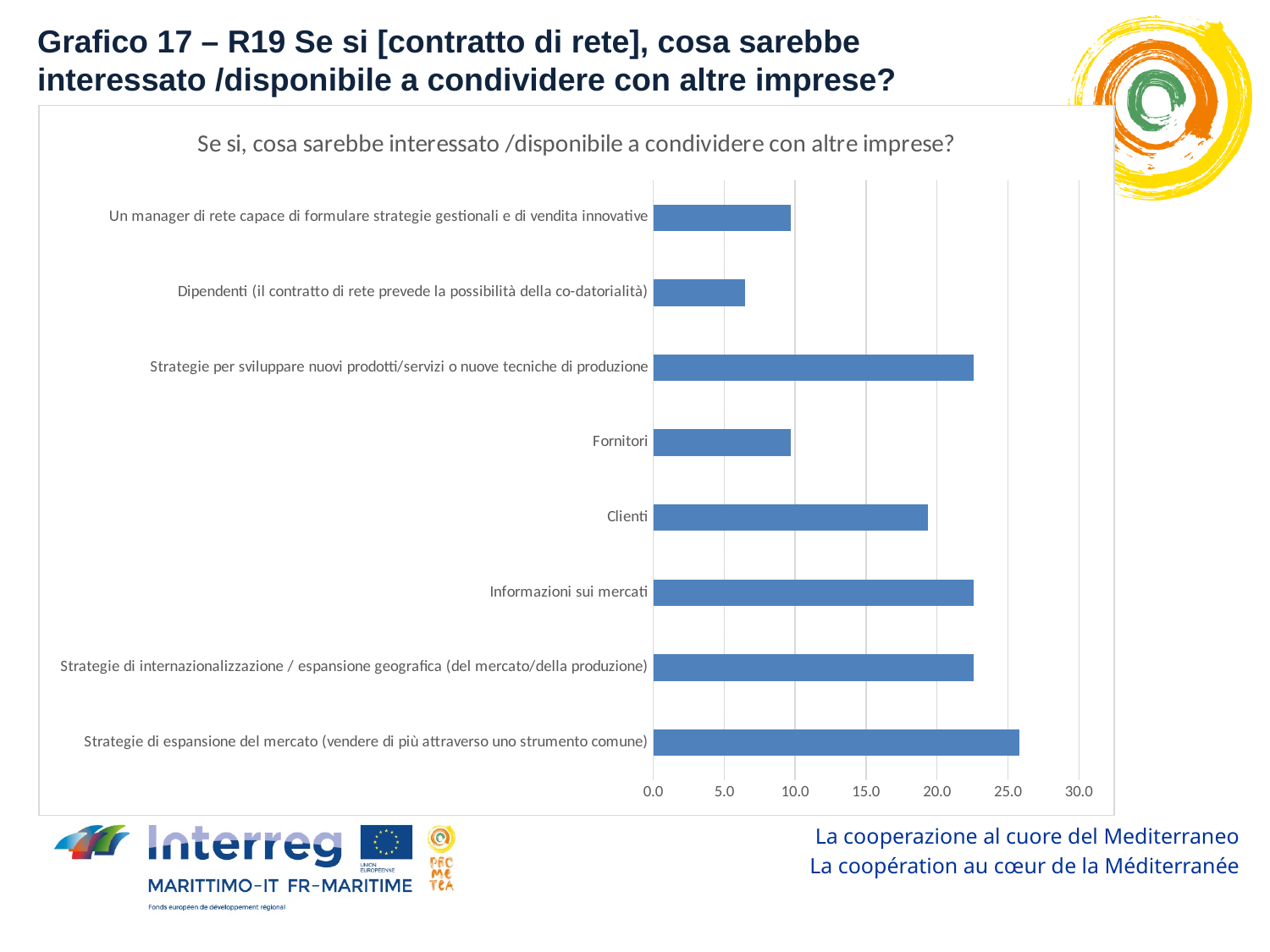
What is the title shown inside the chart area? Se si, cosa sarebbe interessato /disponibile a condividere con altre imprese? Is the value for Dipendenti greater or less than 10.0? less Is the value for Informazioni sui mercati greater or less than 20.0? greater Is the value for Strategie di espansione del mercato greater or less than 25.0? greater How many categories are plotted in the chart? 8 Which has a larger value, Clienti or Dipendenti? Clienti What kind of chart is shown on the slide? bar chart Which has a larger value, Fornitori or Strategie per sviluppare nuovi prodotti/servizi o nuove tecniche di produzione? Strategie per sviluppare nuovi prodotti/servizi o nuove tecniche di produzione Which category has the highest value in the chart? Strategie di espansione del mercato (vendere di più attraverso uno strumento comune) Which category has the lowest value in the chart? Dipendenti (il contratto di rete prevede la possibilità della co-datorialità)